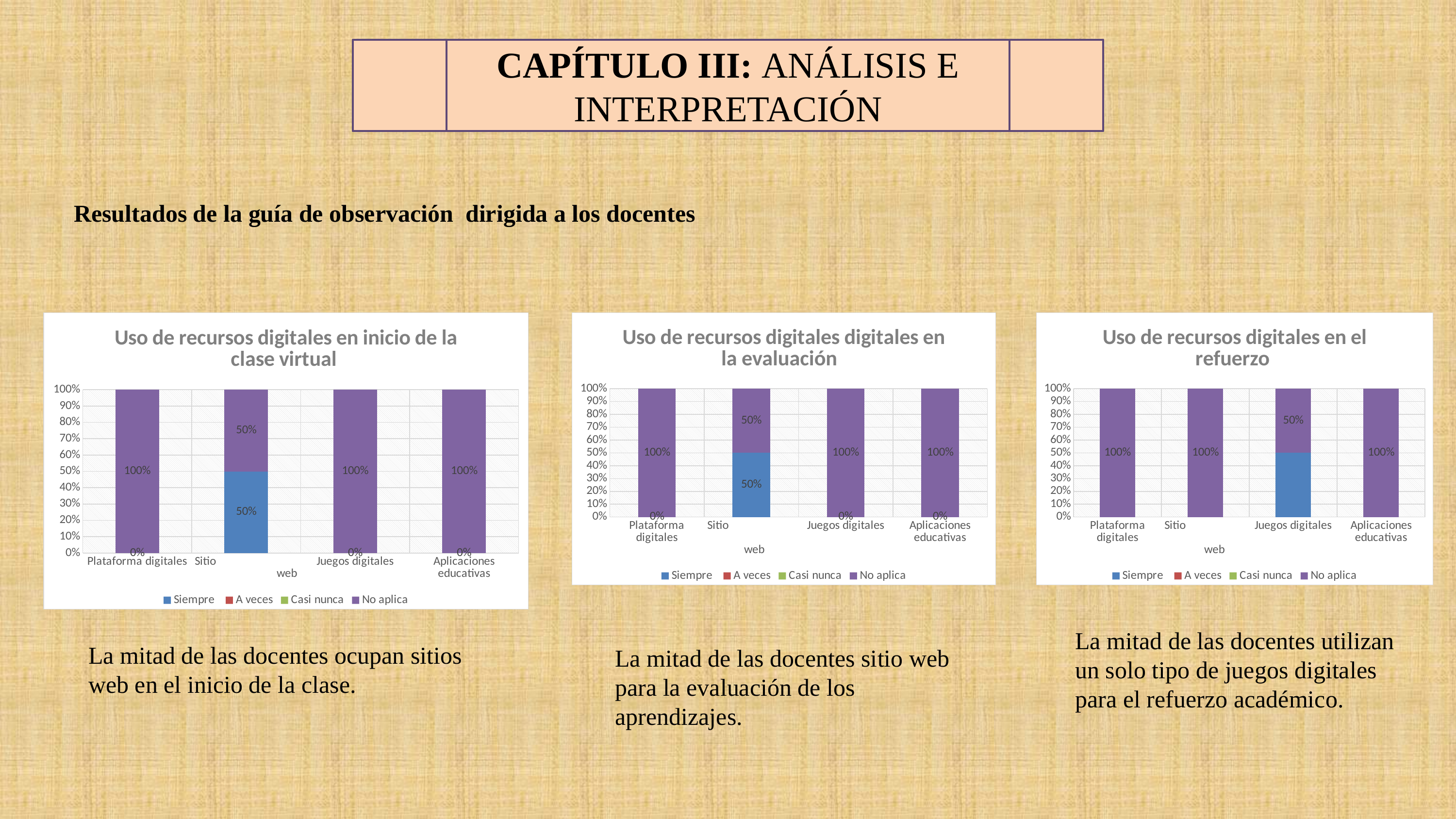
In the chart 'Uso de recursos digitales en inicio de la clase virtual', what is the 'No aplica' value for Plataforma digitales? 100% In the chart 'Uso de recursos digitales en inicio de la clase virtual', what is the 'Siempre' value for Sitio web? 50% What kind of chart is 'Uso de recursos digitales en el refuerzo'? Stacked bar chart In the chart 'Uso de recursos digitales en inicio de la clase virtual', what is the difference between the 'No aplica' value for Plataforma digitales and the 'No aplica' value for Sitio web? 50% In the chart 'Uso de recursos digitales digitales en la evaluación', how many series does the legend list? 4 In the chart 'Uso de recursos digitales en inicio de la clase virtual', how many categories are shown on the x axis? 4 In the chart 'Uso de recursos digitales en inicio de la clase virtual', what is the 'Siempre' value for Juegos digitales? 0% In the chart 'Uso de recursos digitales en el refuerzo', what is the 'No aplica' value for Juegos digitales? 50% In the chart 'Uso de recursos digitales digitales en la evaluación', what is the 'No aplica' value for Aplicaciones educativas? 100% In the chart 'Uso de recursos digitales en el refuerzo', which category has the 'Siempre' series visible above 0%? Juegos digitales In the chart 'Uso de recursos digitales digitales en la evaluación', what is the 'No aplica' value for Sitio web? 50% In the chart 'Uso de recursos digitales en el refuerzo', which series is shown in purple according to the legend? No aplica